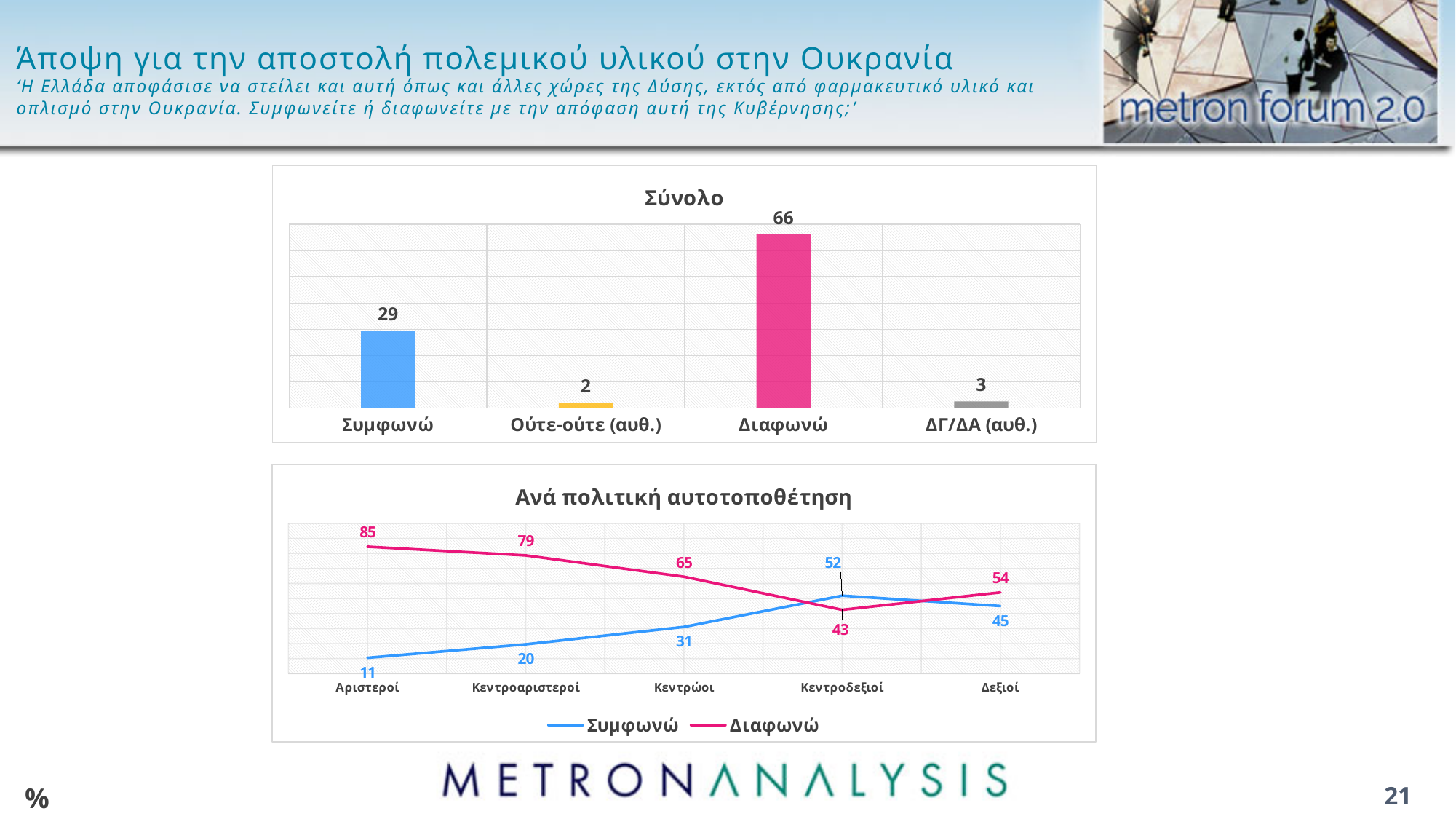
In the 'Σύνολο' chart, what is the value for Διαφωνώ? 66 In the 'Ανά πολιτική αυτοτοποθέτηση' chart, does the Συμφωνώ line rise or fall from Αριστεροί to Κεντροδεξιοί? Rise In the 'Ανά πολιτική αυτοτοποθέτηση' chart, which group has the highest Συμφωνώ value? Κεντροδεξιοί In the 'Ανά πολιτική αυτοτοποθέτηση' chart, what is the Συμφωνώ value for Κεντροδεξιοί? 52 In the 'Σύνολο' chart, what is the value for Συμφωνώ? 29 What kind of chart is the 'Σύνολο' chart? Bar chart In the 'Ανά πολιτική αυτοτοποθέτηση' chart, which is larger for Δεξιοί: Συμφωνώ or Διαφωνώ? Διαφωνώ In the 'Σύνολο' chart, what is the difference between Διαφωνώ and Συμφωνώ? 37 In the 'Σύνολο' chart, how many categories are shown? 4 In the 'Ανά πολιτική αυτοτοποθέτηση' chart, what is the Διαφωνώ value for Αριστεροί? 85 In the 'Ανά πολιτική αυτοτοποθέτηση' chart, how many series does the legend list? 2 In the 'Σύνολο' chart, which category has the lowest value? Ούτε-ούτε (αυθ.)